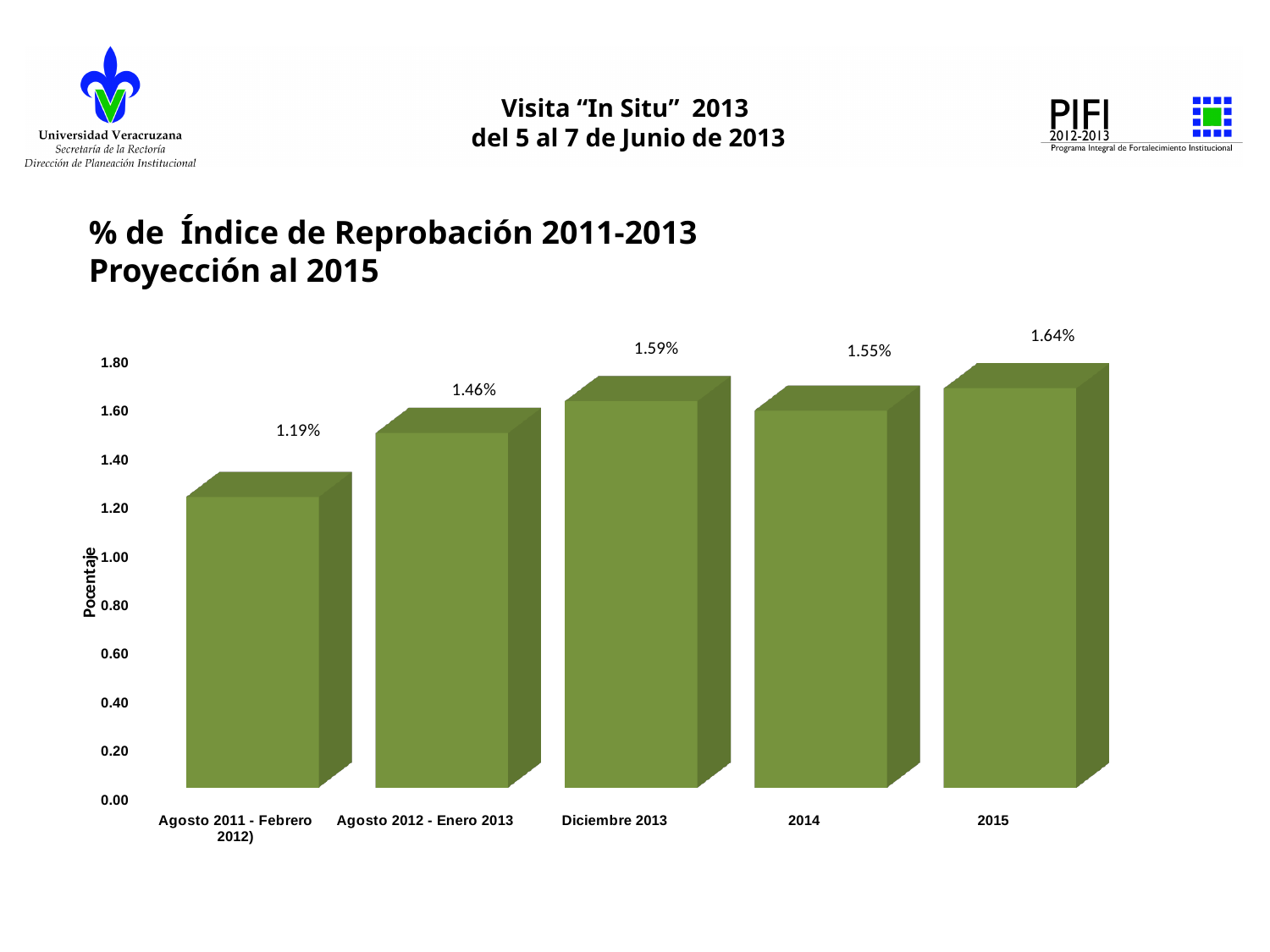
What is the difference between the values for 2015 and Agosto 2011 - Febrero 2012? 0.45% Which is larger, the value for Diciembre 2013 or the value for 2014? Diciembre 2013 What is the value for Agosto 2011 - Febrero 2012? 1.19% What is the label of the vertical axis? Pocentaje What is the value for 2015? 1.64% What kind of chart is shown on the slide? Bar chart What is the value for Diciembre 2013? 1.59% Which category has the lowest value? Agosto 2011 - Febrero 2012 What is the value for Agosto 2012 - Enero 2013? 1.46% How many categories are shown on the x axis? 5 What is the value for 2014? 1.55% Which category has the highest value? 2015